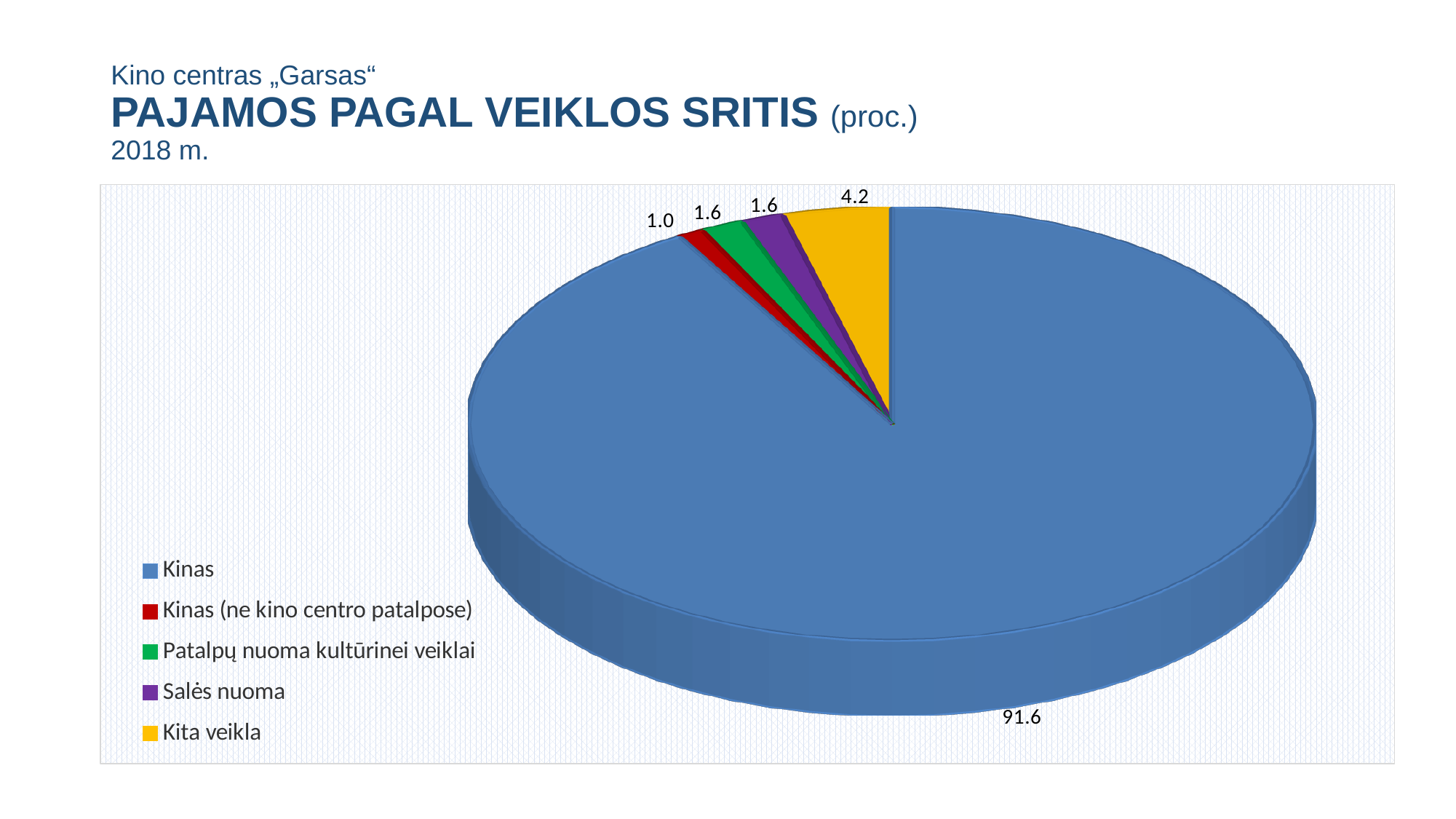
What is the value for Salės nuoma? 1.6 How many categories does the pie chart have? 5 What is the value for Patalpų nuoma kultūrinei veiklai? 1.6 What is the value for Kinas (ne kino centro patalpose)? 1.0 Which category has the largest share of the pie? Kinas Which category has the smallest share of the pie? Kinas (ne kino centro patalpose) What is the value for Kita veikla? 4.2 What is the value for Kinas? 91.6 What is the difference between the values for Kinas and Kita veikla? 87.4 Which is larger, the value for Kita veikla or the value for Salės nuoma? Kita veikla What colour is the slice for Kita veikla? yellow What type of chart is shown on the slide? pie chart